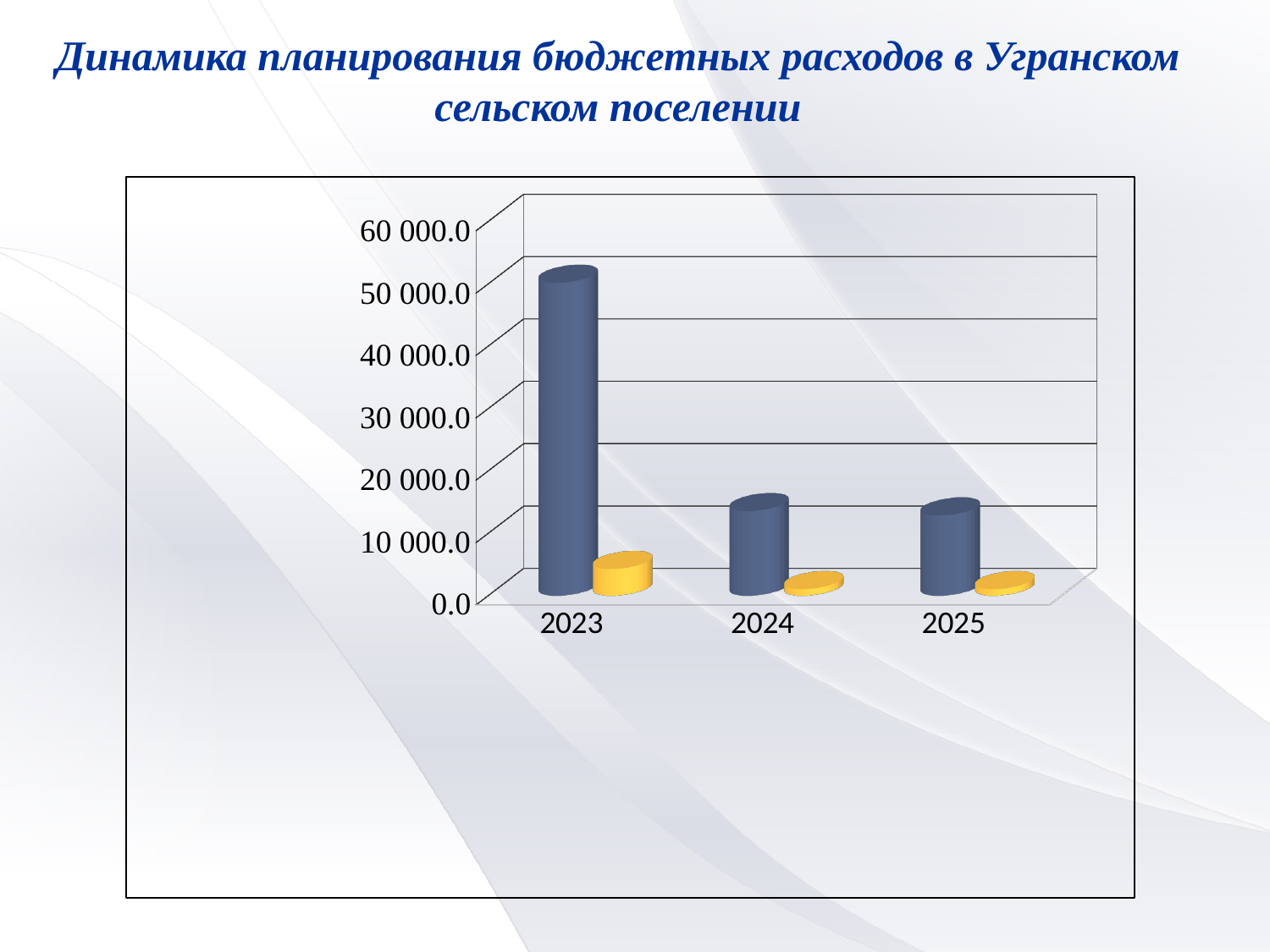
What is the title of the slide containing the chart? Динамика планирования бюджетных расходов в Угранском сельском поселении In 2023, which bar is larger, the blue one or the yellow one? the blue one Is the value of the blue bar for 2024 greater or less than 20 000.0? less Do the blue bars rise or fall from 2023 to 2025? fall Is the value of the yellow bar for 2023 greater or less than 10 000.0? less What is the highest value shown on the vertical axis of the chart? 60 000.0 Is the value of the blue bar for 2025 greater or less than 10 000.0? greater Which year has the tallest blue bar? 2023 What kind of chart is shown on the slide? bar chart Which is larger, the blue bar for 2023 or the blue bar for 2024? 2023 How many years are shown on the x axis of the chart? 3